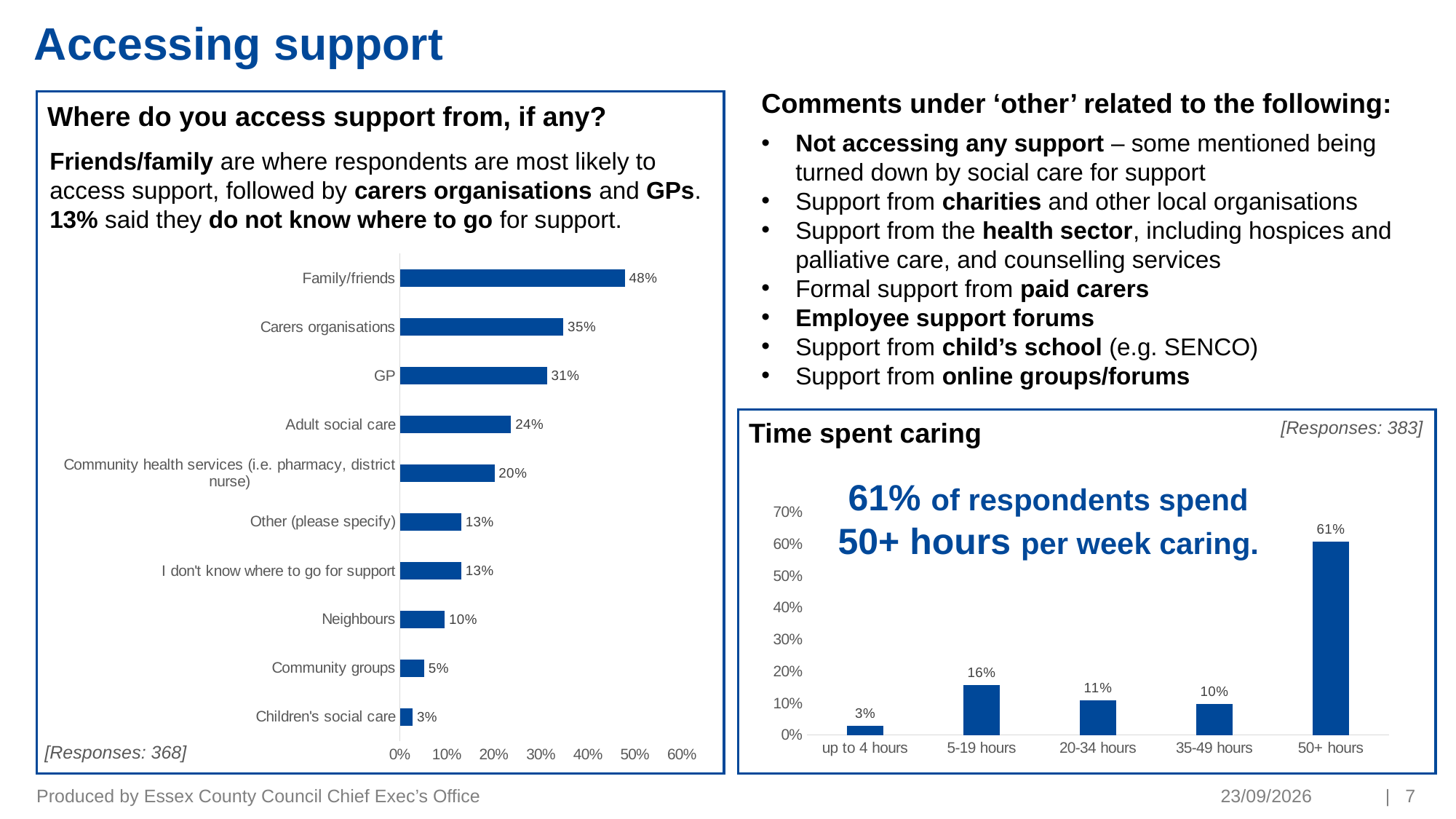
In the 'Where do you access support from, if any?' chart, which category has the highest value? Family/friends In the 'Time spent caring' chart, how many categories are shown on the x axis? 5 In the 'Where do you access support from, if any?' chart, how many categories are shown? 10 In the 'Time spent caring' chart, what is the difference between the values for 50+ hours and up to 4 hours? 58% In the 'Time spent caring' chart, which is larger: 5-19 hours or 35-49 hours? 5-19 hours In the 'Where do you access support from, if any?' chart, what is the value for Carers organisations? 35% In the 'Time spent caring' chart, which category has the highest value? 50+ hours What kind of chart is the 'Where do you access support from, if any?' chart? Bar chart In the 'Where do you access support from, if any?' chart, which category has the lowest value? Children's social care In the 'Where do you access support from, if any?' chart, what is the value for Neighbours? 10% In the 'Time spent caring' chart, what is the value for 20-34 hours? 11% In the 'Where do you access support from, if any?' chart, what is the difference between the values for GP and Adult social care? 7%